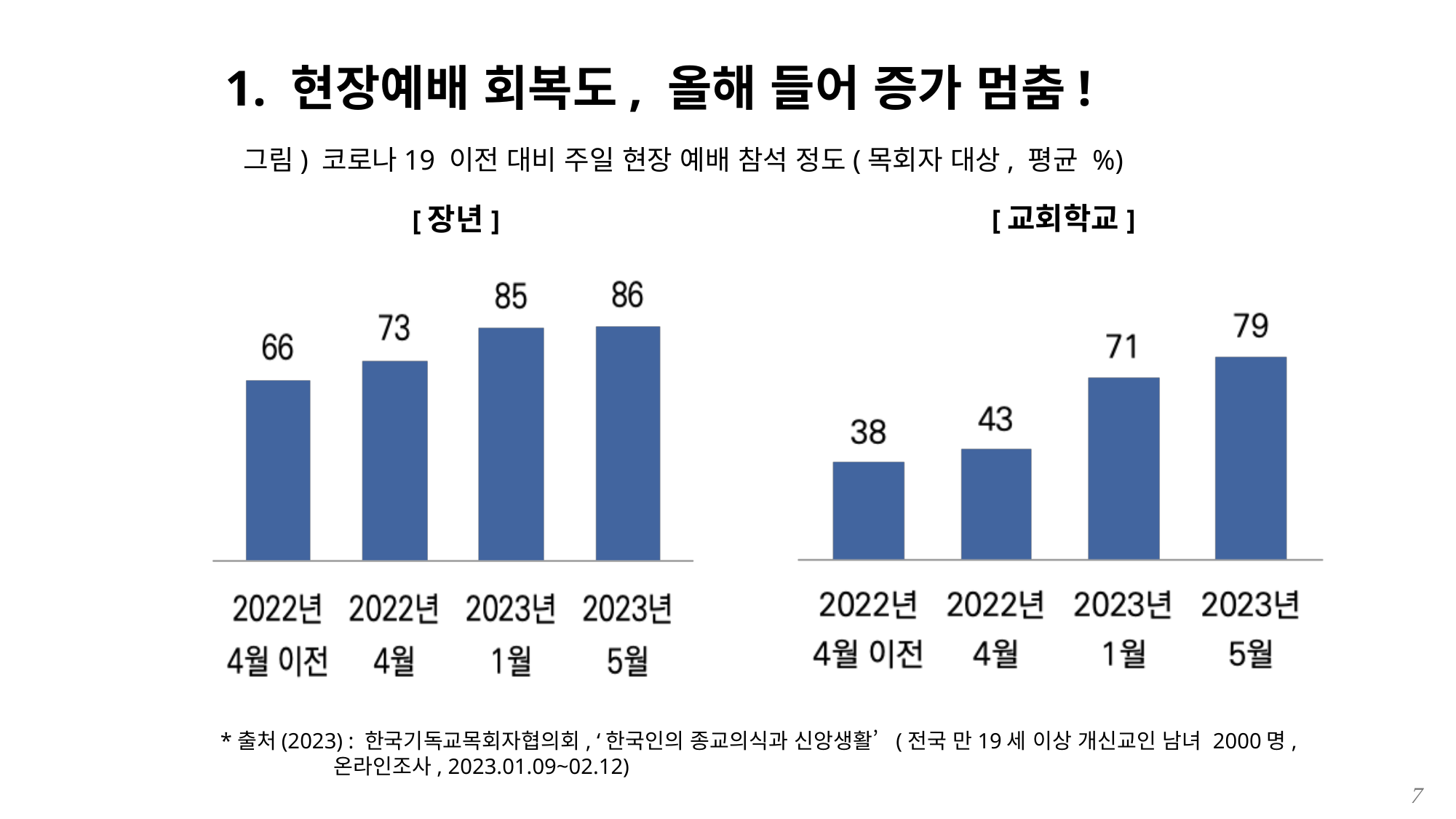
Which is larger: the value for 2023년 5월 in the [장년] chart or the value for 2023년 5월 in the [교회학교] chart? [장년] chart (86) In the [교회학교] chart, which category has the lowest value? 2022년 4월 이전 What is the value for 2022년 4월 in the [장년] chart? 73 In the [교회학교] chart, what is the value for 2023년 1월? 71 In the [교회학교] chart, do the values rise or fall from 2022년 4월 이전 to 2023년 5월? Rise In the [장년] chart, what is the value for 2022년 4월 이전? 66 In the [교회학교] chart, what is the difference between the values for 2023년 5월 and 2022년 4월 이전? 41 What kind of chart is the [교회학교] chart? Bar chart In the [교회학교] chart, which is larger: the value for 2022년 4월 or the value for 2023년 1월? 2023년 1월 How many categories are shown in the [장년] chart? 4 In the [장년] chart, which category has the highest value? 2023년 5월 In the [장년] chart, what is the difference between the values for 2023년 1월 and 2022년 4월? 12